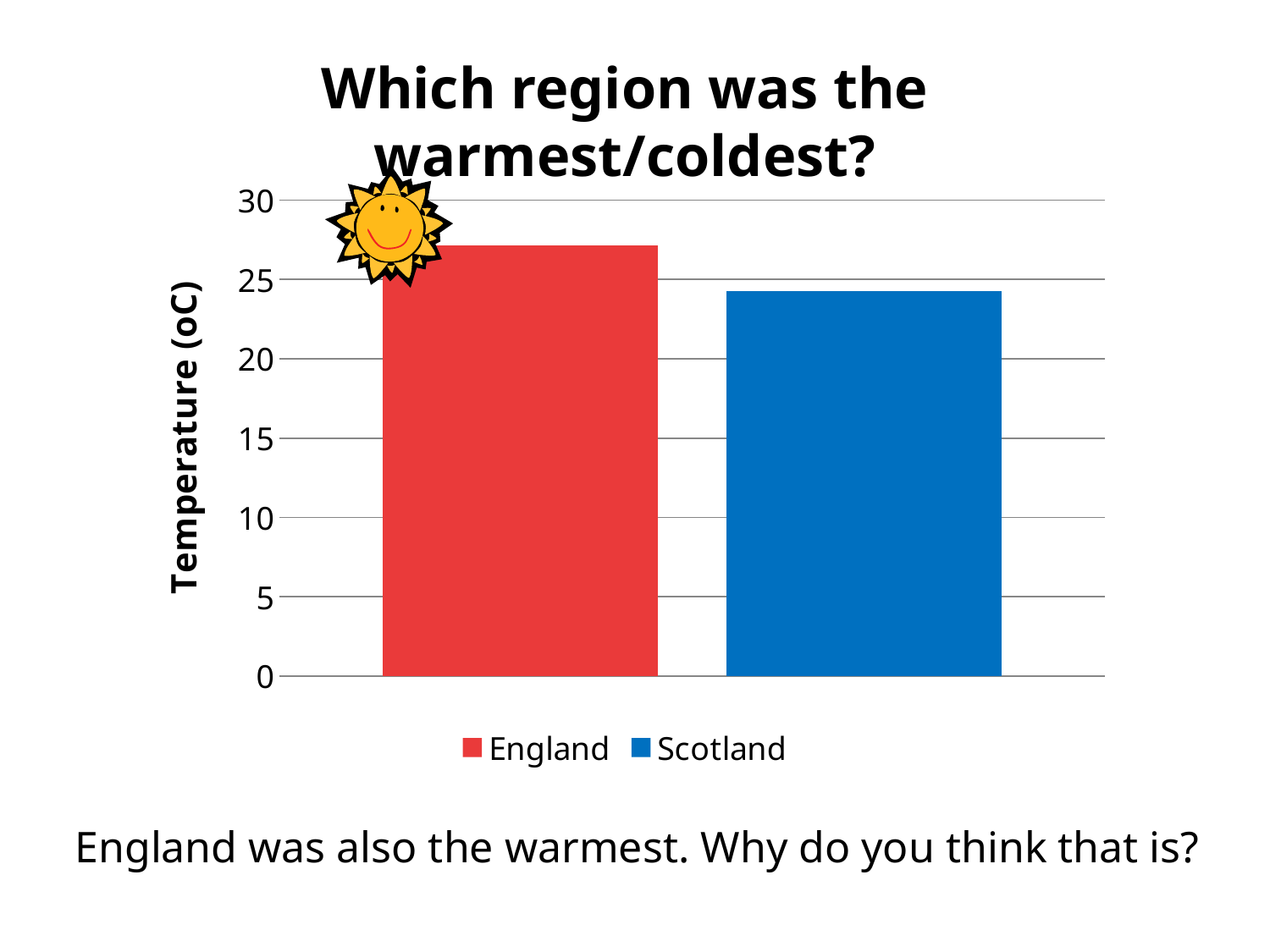
Is the value for England greater or less than 30? less How many bars are plotted in the chart? 2 Is the value for Scotland greater or less than 25? less Which region has the highest temperature in the chart? England How many series does the legend list? 2 What is the label on the vertical axis of the chart? Temperature (oC) What kind of chart is shown on the slide? bar chart Which is larger, the temperature for England or for Scotland? England Which region has the lowest temperature in the chart? Scotland Is the value for Scotland greater or less than 20? greater What colour is the bar for Scotland? blue